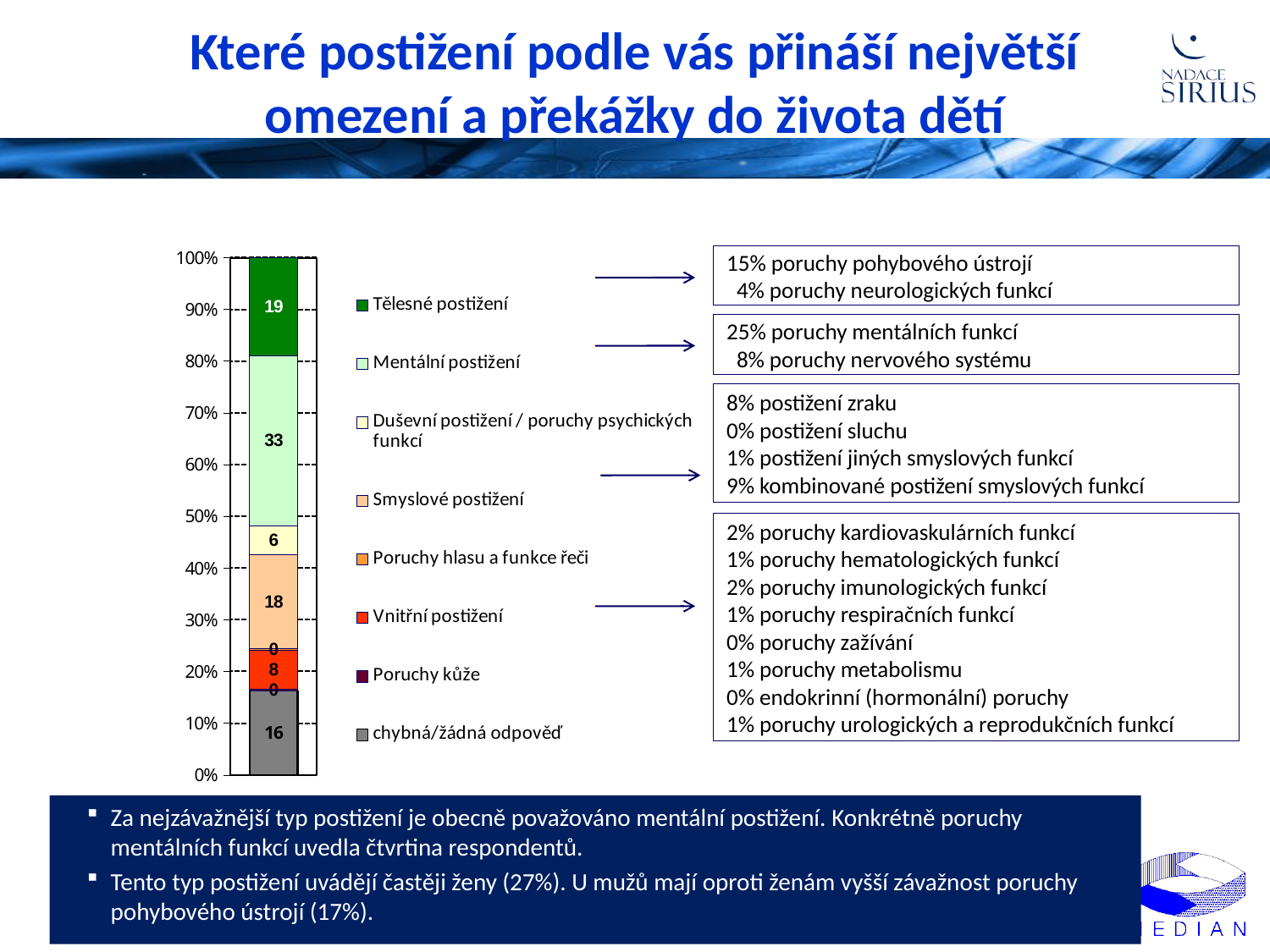
Which is larger, the value for Smyslové postižení or the value for Vnitřní postižení? Smyslové postižení What is the value labelled for Mentální postižení in the stacked bar? 33 What is the value labelled for Vnitřní postižení in the stacked bar? 8 Which category has the largest segment in the stacked bar? Mentální postižení What kind of chart is shown on the slide? stacked bar chart What is the value labelled for chybná/žádná odpověď in the stacked bar? 16 What colour is the segment for Tělesné postižení in the stacked bar? green What is the total of all segments in the stacked bar? 100 How many entries does the legend of the chart list? 8 What is the difference between the values for Mentální postižení and Tělesné postižení? 14 What is the value labelled for Smyslové postižení in the stacked bar? 18 What is the value labelled for Tělesné postižení in the stacked bar? 19